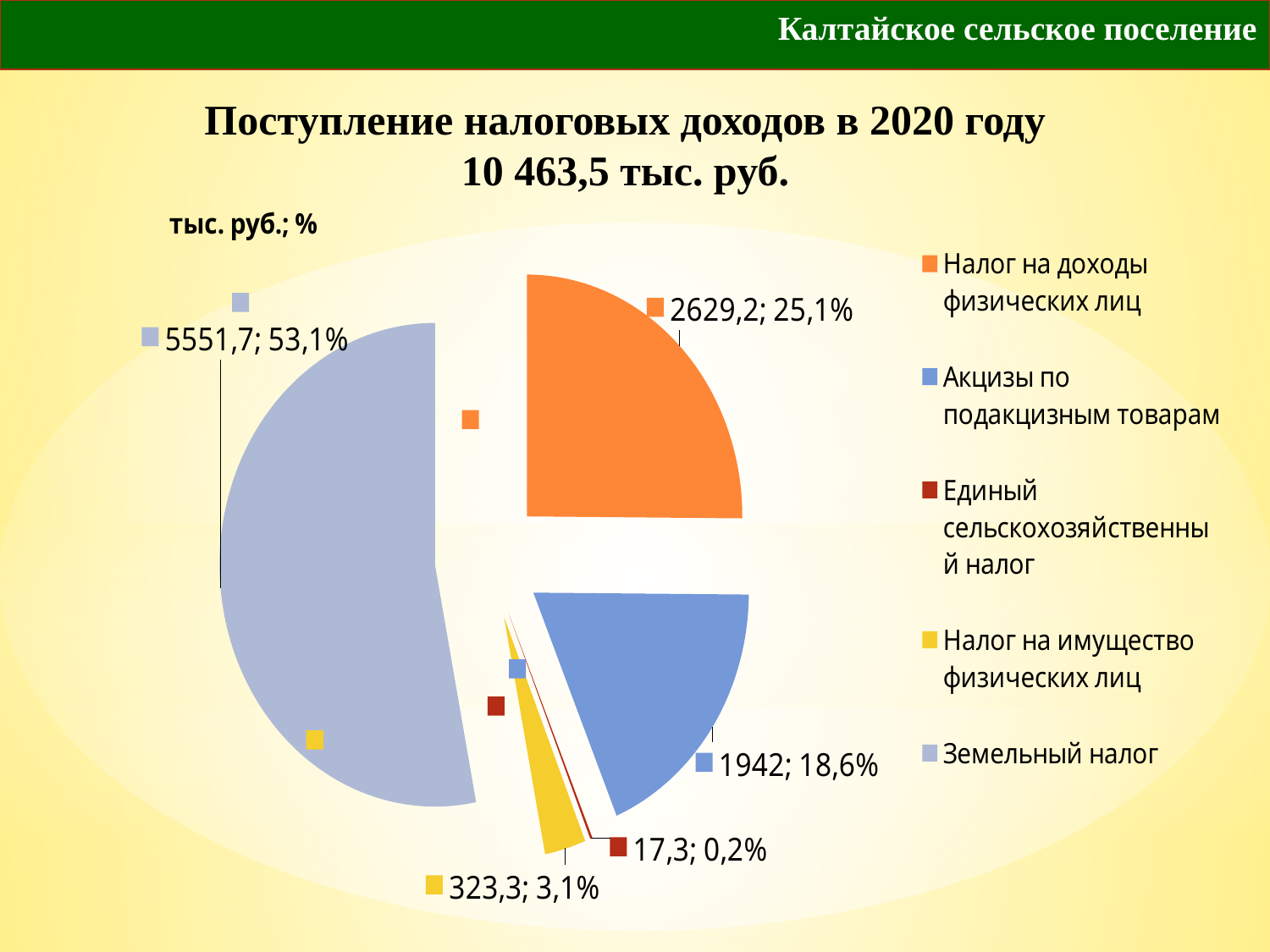
Which category has the largest slice of the pie? Земельный налог How many slices does the pie chart have? 5 What value is shown for Земельный налог? 5551,7 Which category has the smallest slice of the pie? Единый сельскохозяйственный налог What is the difference between the values for Налог на доходы физических лиц and Акцизы по подакцизным товарам? 687,2 What kind of chart is shown on the slide? pie chart What value is shown for Акцизы по подакцизным товарам? 1942 What share of the pie does Единый сельскохозяйственный налог have? 0,2% What share of the pie does Налог на доходы физических лиц have? 25,1% Which is larger: Налог на доходы физических лиц or Акцизы по подакцизным товарам? Налог на доходы физических лиц What value is shown for Налог на имущество физических лиц? 323,3 What is the title of the chart? Поступление налоговых доходов в 2020 году 10 463,5 тыс. руб.